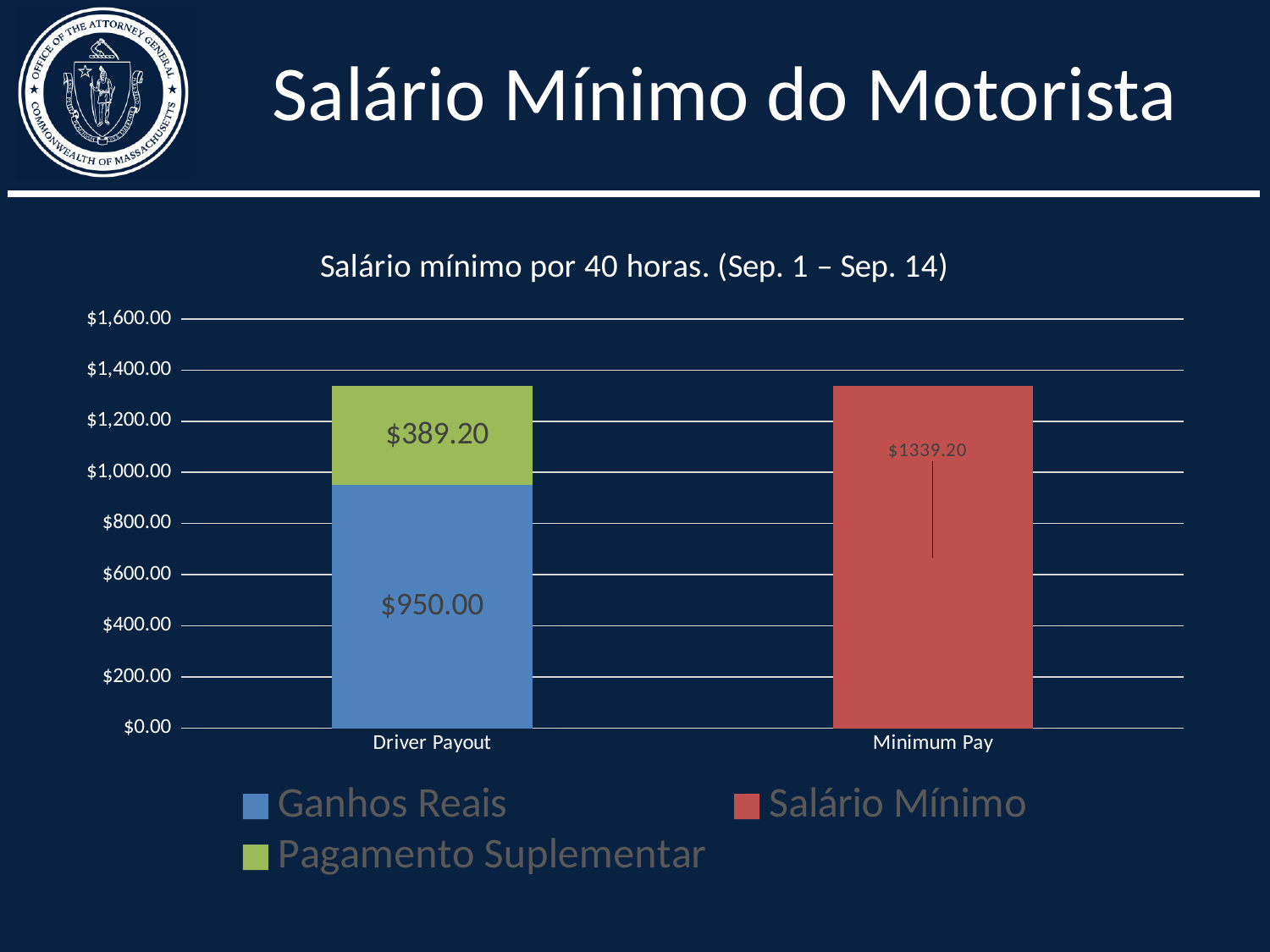
Which is larger in the Driver Payout bar, Ganhos Reais or Pagamento Suplementar? Ganhos Reais What is the value of Salário Mínimo for Minimum Pay? $1339.20 What is the title of the chart? Salário mínimo por 40 horas. (Sep. 1 – Sep. 14) What is the total of the stacked Driver Payout bar? $1339.20 What is the value of Ganhos Reais for Driver Payout? $950.00 What kind of chart is shown on the slide? Stacked bar chart What is the difference between Ganhos Reais and Pagamento Suplementar in the Driver Payout bar? $560.80 How many series does the legend list? 3 Is the Ganhos Reais value for Driver Payout greater or less than $1,000.00? less How many categories are shown on the x axis? 2 What is the value of Pagamento Suplementar for Driver Payout? $389.20 Is the value for Minimum Pay greater or less than $1,200.00? greater